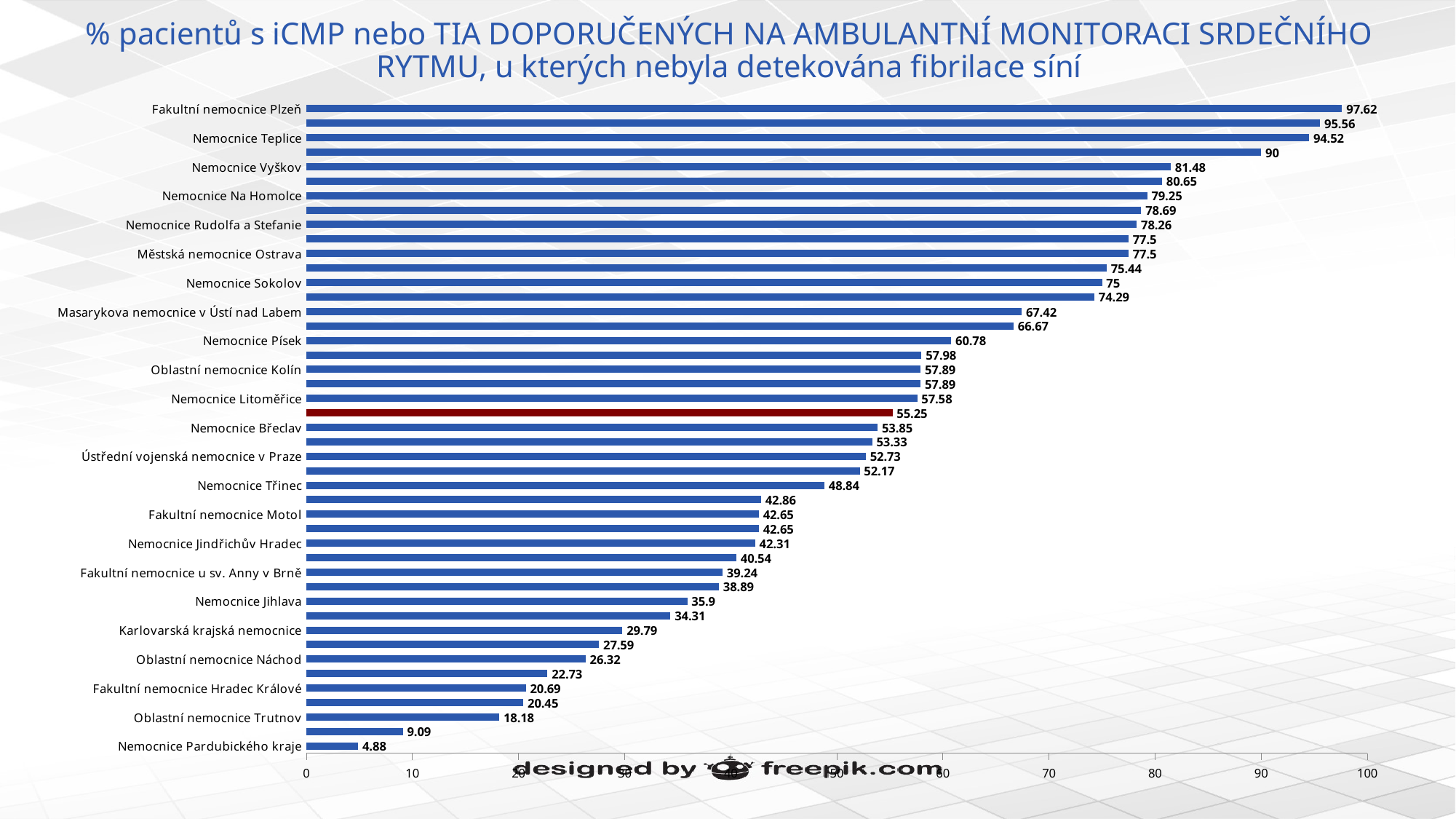
Which hospital has the highest value? Fakultní nemocnice Plzeň What is the value for Fakultní nemocnice Plzeň? 97.62 Which hospital has the lowest value? Nemocnice Pardubického kraje What is the value for Nemocnice Pardubického kraje? 4.88 What is the difference between the values for Nemocnice Teplice and Nemocnice Vyškov? 13.04 Which is larger, the value for Nemocnice Jihlava or for Karlovarská krajská nemocnice? Nemocnice Jihlava What is the value for Nemocnice Sokolov? 75 Do the values increase or decrease going from the top bar to the bottom bar? decrease What is the value of the bar highlighted in dark red? 55.25 Is the value for Oblastní nemocnice Náchod greater or less than 30? less What kind of chart is shown on the slide? bar chart What is the value for Fakultní nemocnice Motol? 42.65